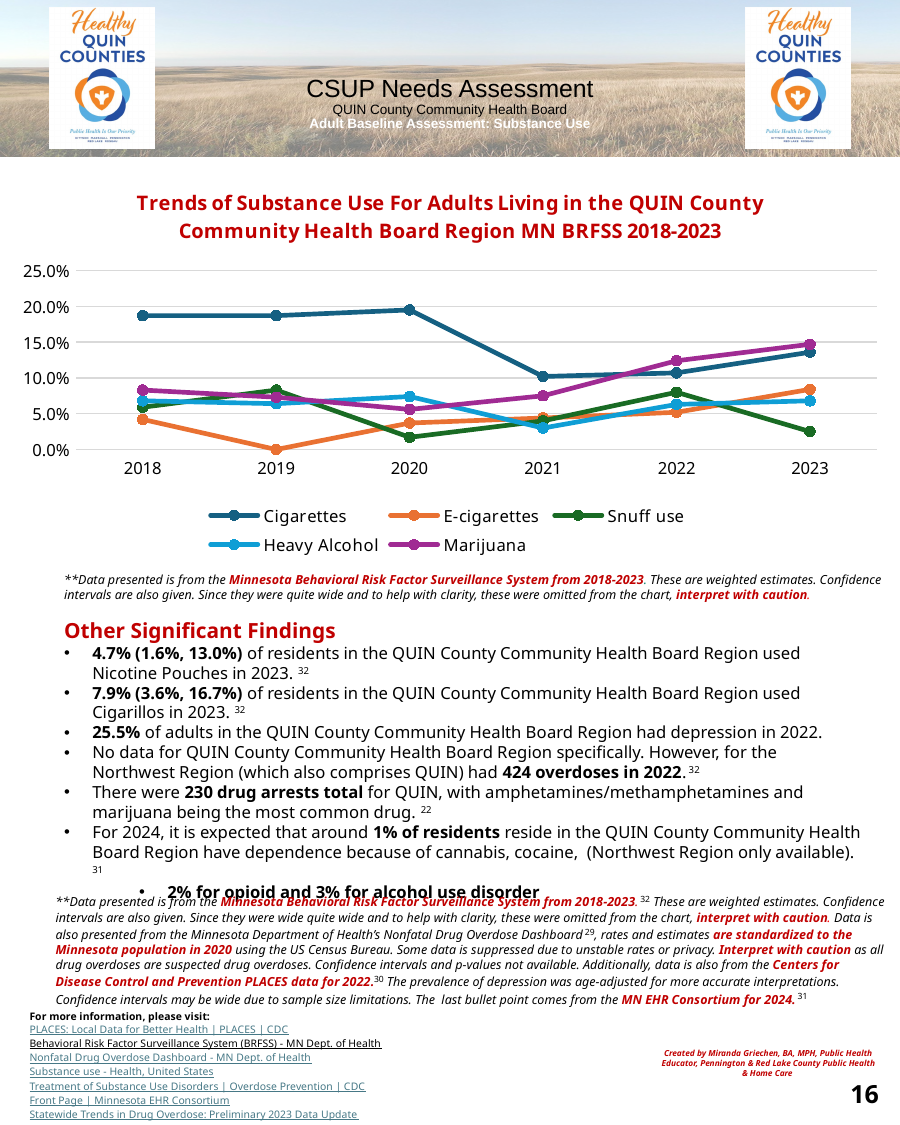
What is the title of the chart? Trends of Substance Use For Adults Living in the QUIN County Community Health Board Region MN BRFSS 2018-2023 In 2020, which is larger: the value for Cigarettes or the value for Marijuana? Cigarettes How many series does the chart's legend list? 5 Is the value for Cigarettes in 2021 greater or less than 15.0%? less Which series has the lowest value in 2019? E-cigarettes What kind of chart is shown on the slide? Line chart Is the value for Cigarettes in 2018 greater or less than 15.0%? greater Is the value for E-cigarettes in 2019 greater or less than 5.0%? less Which series has the highest value in 2018? Cigarettes How many years are plotted along the x axis of the chart? 6 Does the Marijuana line rise or fall from 2020 to 2023? Rise Which series has the lowest value in 2023? Snuff use